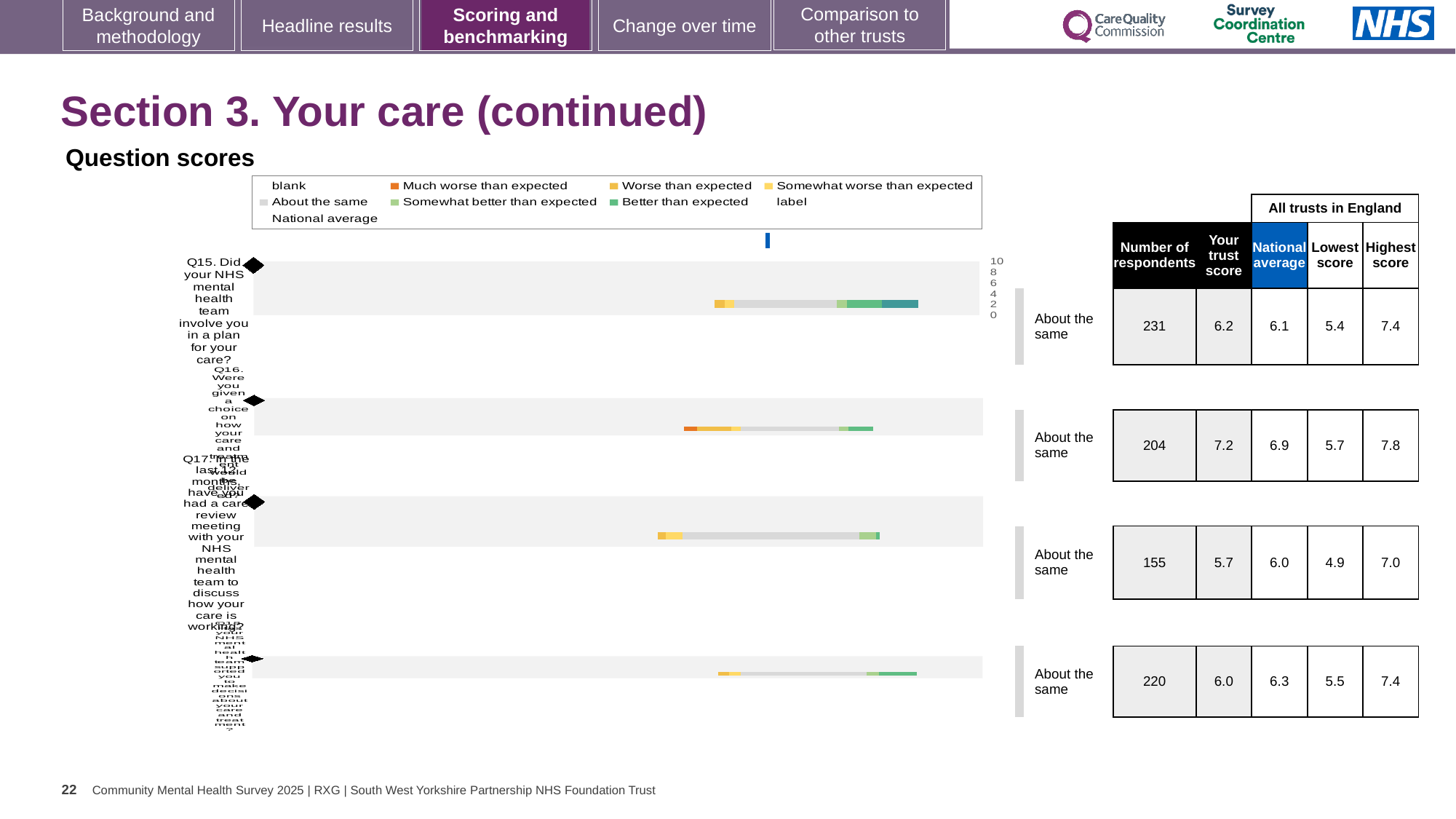
For Q15, which is larger: the trust score or the national average? the trust score What is the trust score for Q15 (involving you in a plan for your care)? 6.2 What benchmark category is shown for Q15? About the same What is the lowest score among all trusts in England for Q17? 4.9 What is the national average score for Q17 (care review meeting)? 6.0 Which question has the lowest trust score? Q17 What is the highest score among all trusts in England for Q16? 7.8 By how much does the trust score for Q16 exceed the national average for Q16? 0.3 Which question has the highest trust score? Q16 How many respondents answered Q16? 204 What kind of chart is used to show the question scores on this slide? bar chart How many question bars are plotted in the question scores chart? 4